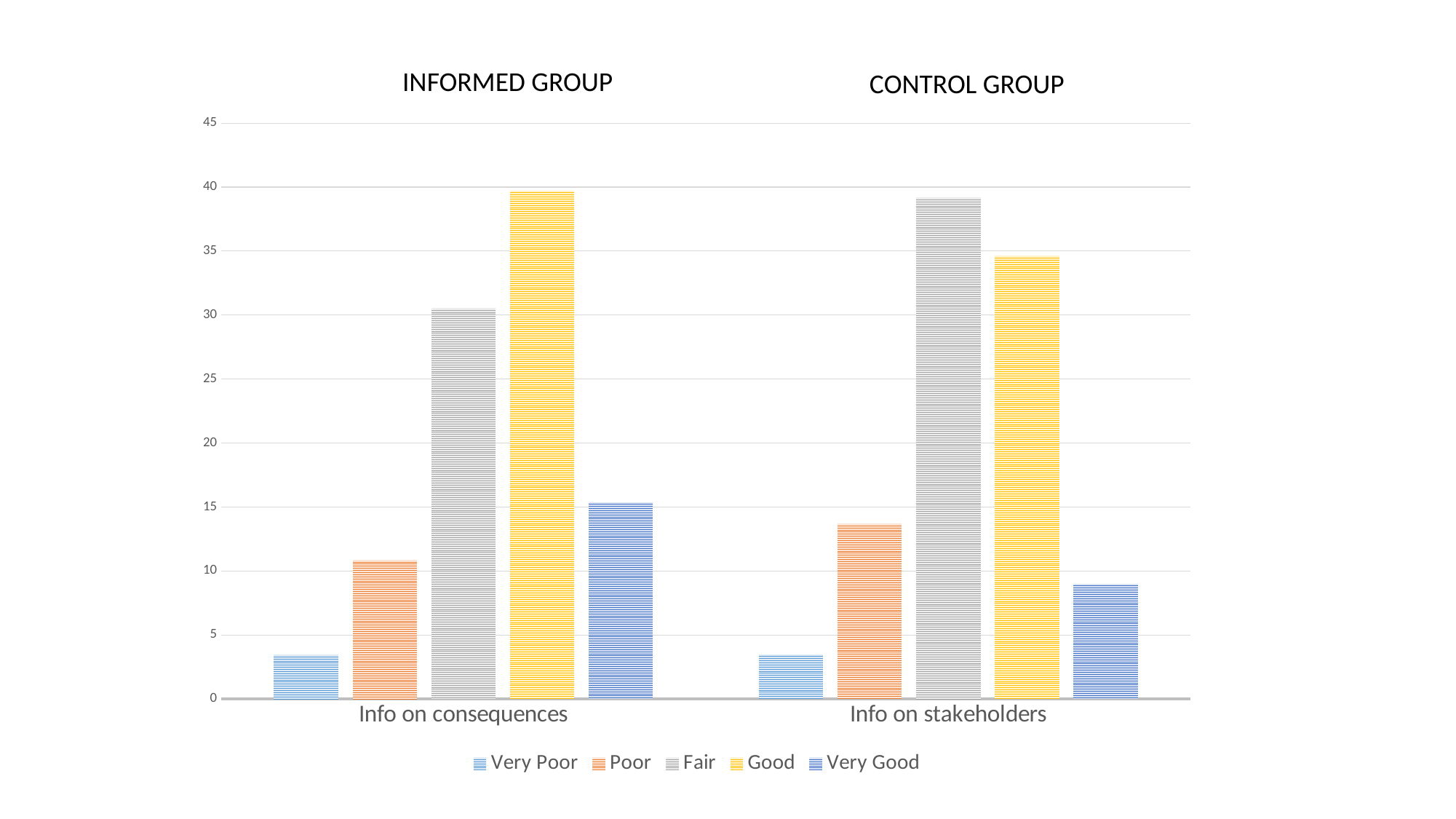
What are the legend entries of the chart, in order? Very Poor, Poor, Fair, Good, Very Good How many categories are shown on the x axis? 2 Is the value for Good under Info on consequences greater or less than 35? greater Which is larger: the Very Good value for Info on consequences or the Very Good value for Info on stakeholders? Info on consequences For Info on consequences, which series has the highest bar? Good Which is larger: the Poor value for Info on consequences or the Poor value for Info on stakeholders? Info on stakeholders What kind of chart is shown on the slide? bar chart For Info on stakeholders, which series has the highest bar? Fair Is the value for Very Good under Info on stakeholders greater or less than 10? less For Info on consequences, which series has the lowest bar? Very Poor How many series does the legend list? 5 Is the value for Fair under Info on consequences greater or less than 35? less